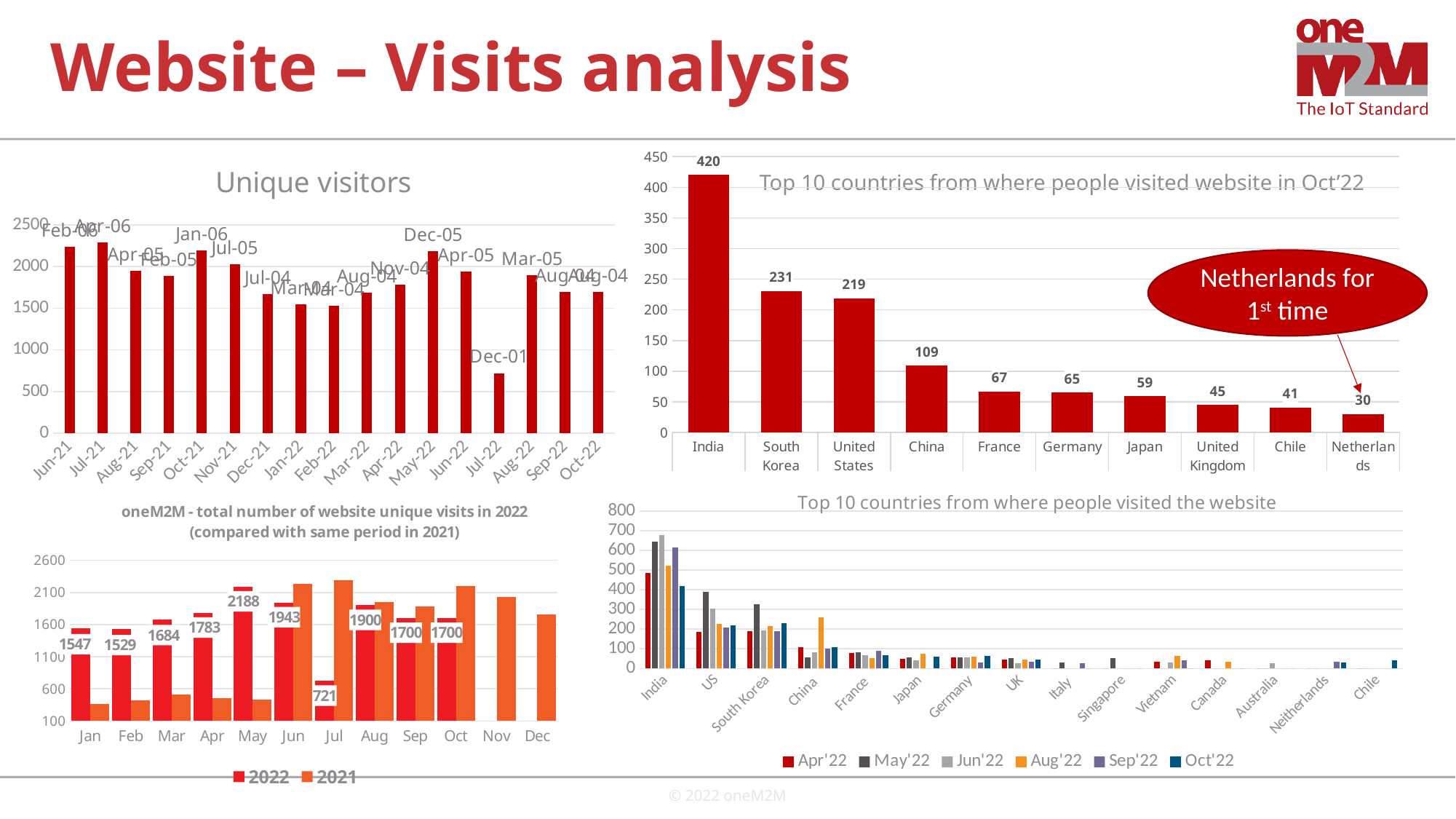
In the 'Unique visitors' chart, which month has the lowest value? Jul-22 What kind of chart is the 'Unique visitors' chart? bar chart In the 'oneM2M - total number of website unique visits in 2022' chart, what is the difference between the 2022 values for Jun and Jan? 396 In the 'Top 10 countries from where people visited website in Oct'22' chart, which is larger, France or Germany? France In the 'oneM2M - total number of website unique visits in 2022' chart, which month has the lowest 2022 value? Jul In the 'Top 10 countries from where people visited the website' chart at the bottom right, is the May'22 value for India greater or less than 600? greater How many series does the legend list in the 'Top 10 countries from where people visited the website' chart at the bottom right? 6 In the 'Top 10 countries from where people visited website in Oct'22' chart, what is the difference between South Korea and United States? 12 In the 'Top 10 countries from where people visited website in Oct'22' chart, what is the value for India? 420 How many countries are shown in the 'Top 10 countries from where people visited website in Oct'22' chart? 10 In the 'Top 10 countries from where people visited website in Oct'22' chart, which country has the lowest value? Netherlands In the 'oneM2M - total number of website unique visits in 2022' chart, what is the 2022 value for May? 2188